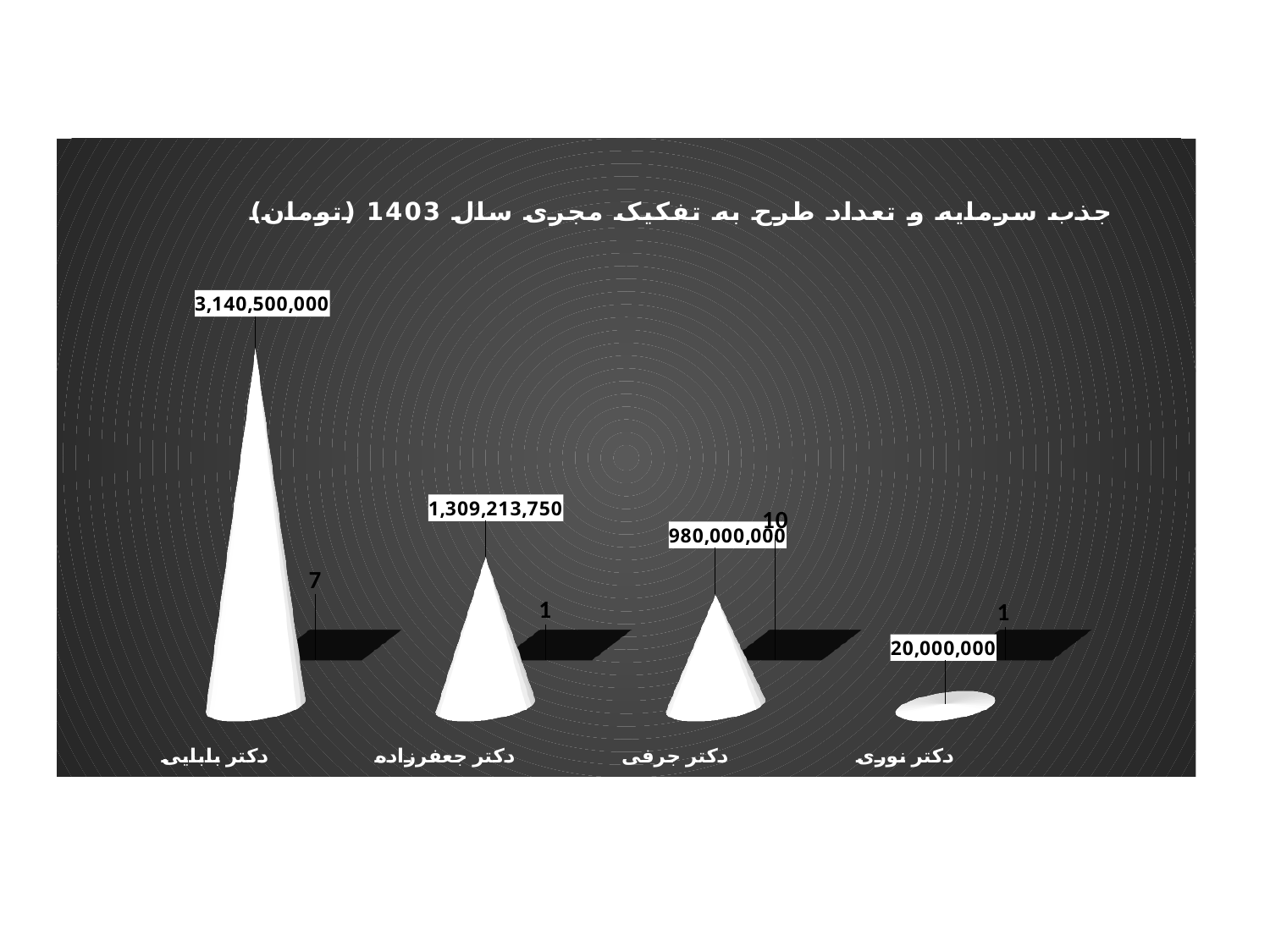
Which executor has the highest capital attraction value? دکتر بابایی Which executor has the lowest capital attraction value? دکتر نوری Which executor has the highest number of projects? دکتر جرفی How many projects (تعداد طرح) are shown for دکتر جرفی? 10 What is the capital attraction value (تومان) shown for دکتر جرفی? 980,000,000 What is the capital attraction value (تومان) shown for دکتر جعفرزاده? 1,309,213,750 How many projects (تعداد طرح) are shown for دکتر بابایی? 7 How many executors (categories) are shown on the chart? 4 What is the difference between the capital attraction values of دکتر بابایی and دکتر جعفرزاده? 1,831,286,250 What is the capital attraction value (تومان) shown for دکتر نوری? 20,000,000 What is the capital attraction value (تومان) shown for دکتر بابایی? 3,140,500,000 Which has a larger capital attraction value, دکتر جرفی or دکتر نوری? دکتر جرفی